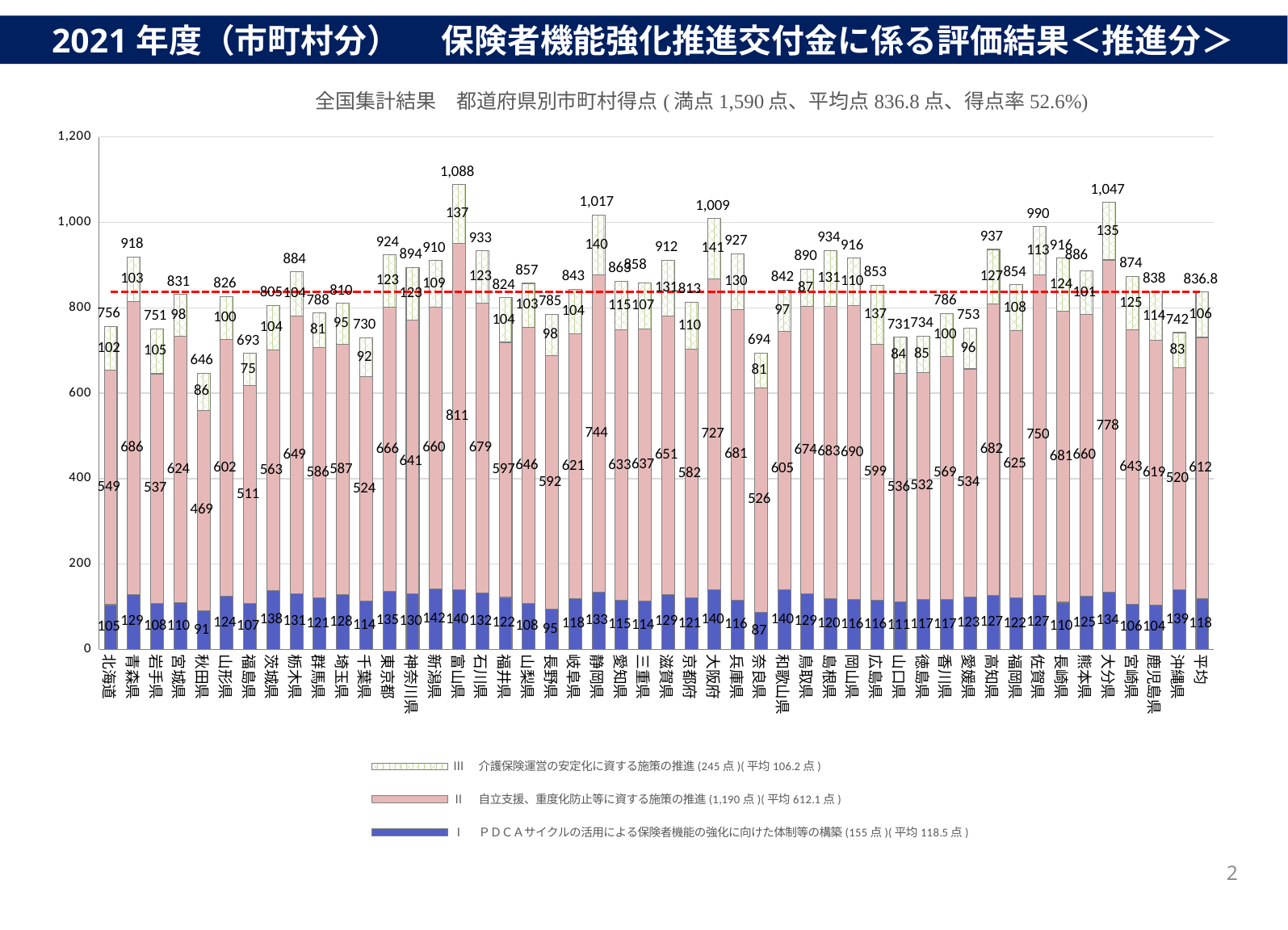
Which prefecture has the highest total score? 富山県 How many series does the legend list? 3 Which prefecture has the lowest total score? 秋田県 What is the value of series II (pink segment) for 大分県? 778 What is the value of series I (blue segment) for 北海道? 105 What is the total score shown for the 平均 (average) bar? 836.8 Is the total score for 秋田県 greater or less than 800? less Which has a higher total score, 静岡県 or 大阪府? 静岡県 What is the total score shown for 富山県? 1,088 What is the difference between the total scores of 富山県 and 大分県? 41 What kind of chart is shown on the slide? Stacked bar chart with a horizontal dashed average line What value does the red dashed horizontal line mark? 836.8